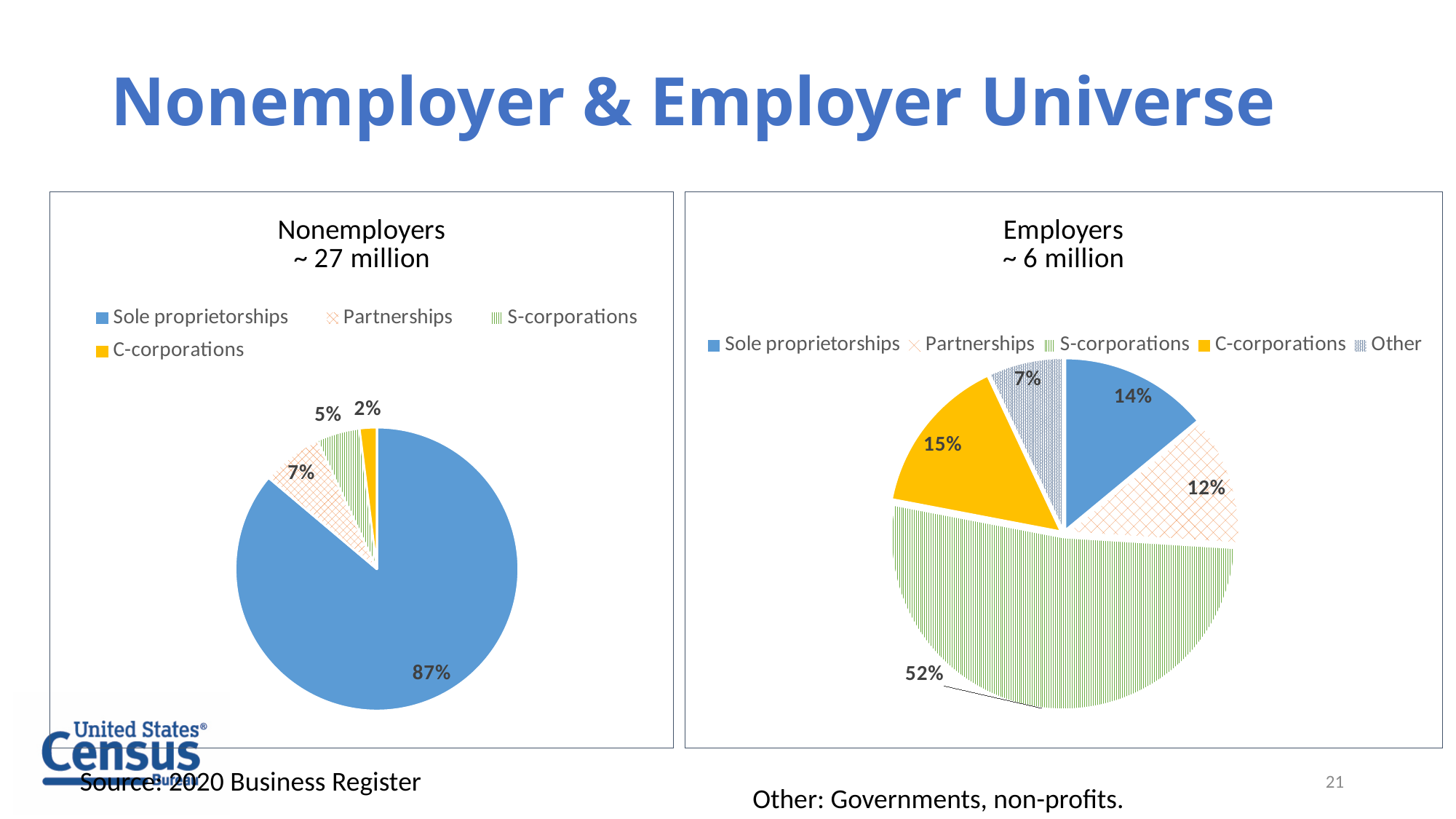
In the Nonemployers chart, what share of the pie is Sole proprietorships? 87% What approximate total is given in the title of the Employers chart? ~ 6 million In the Nonemployers chart, which category has the smallest slice? C-corporations What type of chart is used for the Nonemployers data? Pie chart How many slices does the Employers pie chart have? 5 In the Employers chart, which category has the largest slice? S-corporations In the Employers chart, what percentage is labelled for C-corporations? 15% In the Employers chart, which category has the smallest slice? Other In the Employers chart, what share of the pie is S-corporations? 52% In the Nonemployers chart, what is the difference in percentage points between Partnerships and S-corporations? 2 How many entries does the legend of the Nonemployers chart list? 4 In the Employers chart, which is larger: Sole proprietorships or Partnerships? Sole proprietorships